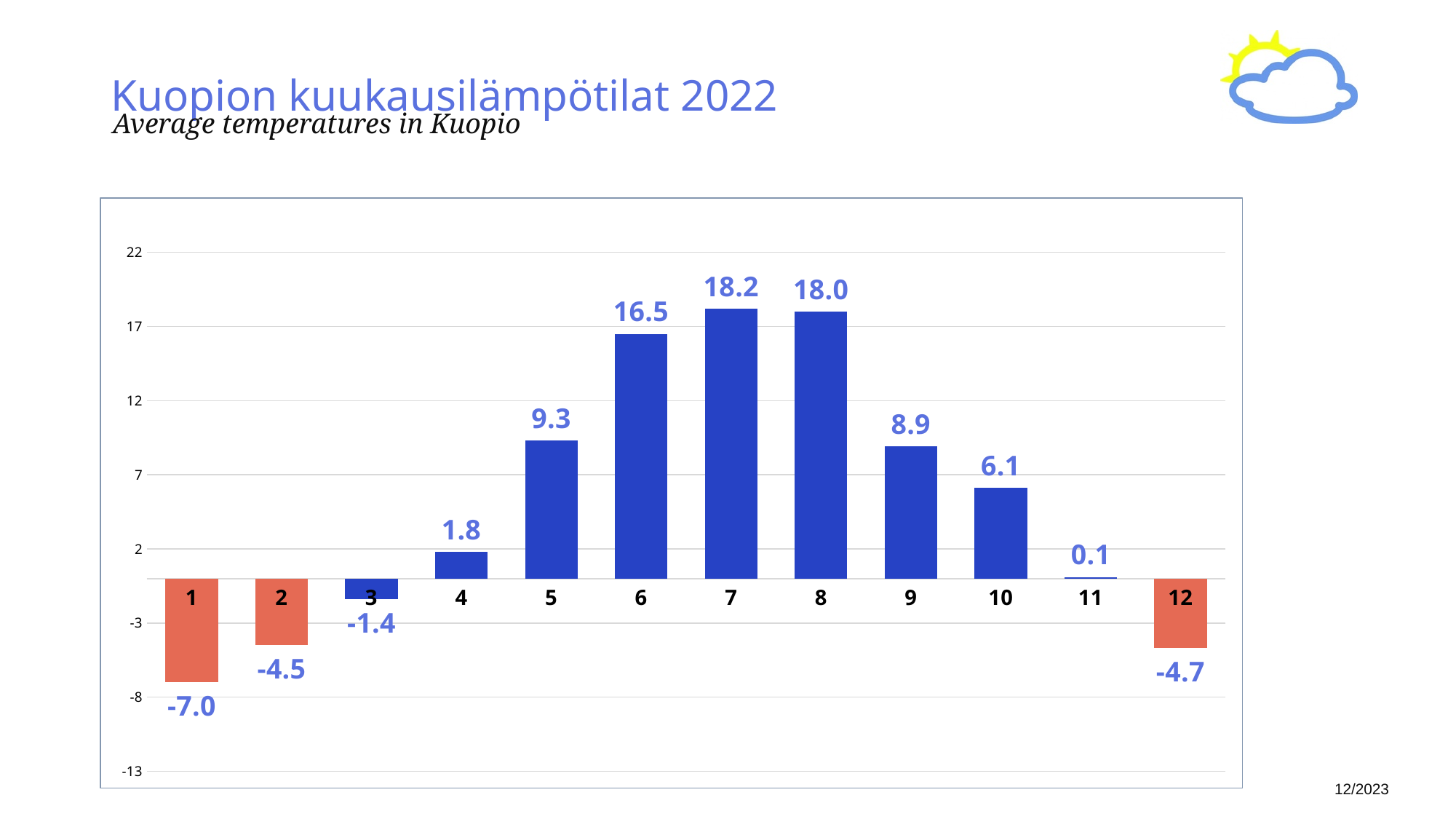
What is the difference between the values for month 5 and month 9? 0.4 Is the value for month 6 greater or less than 12? greater How many months are shown on the x axis? 12 Which month has the lowest value? 1 What kind of chart is shown on the slide? bar chart How many bars are coloured red/orange rather than blue? 3 What is the value for month 11? 0.1 What is the value for month 1? -7.0 Which is larger, the value for month 6 or the value for month 10? month 6 What is the difference between the values for month 7 and month 8? 0.2 Which month has the highest value? 7 What is the value for month 7? 18.2